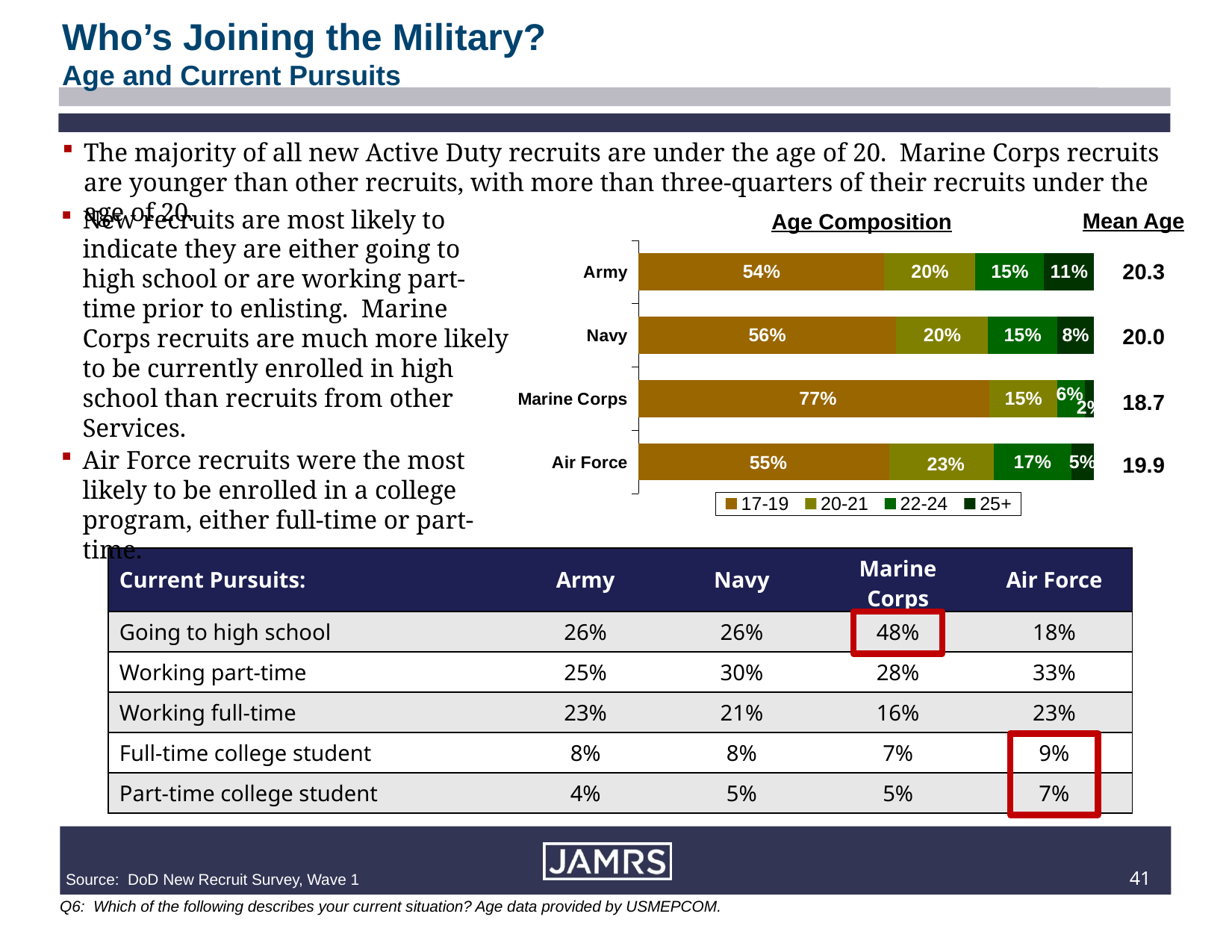
In the Age Composition chart, what is the difference between the 17-19 share for the Marine Corps and for the Army? 23% What kind of chart is the Age Composition chart? stacked bar chart How many age groups does the legend of the Age Composition chart list? 4 In the Age Composition chart, what percentage of Marine Corps recruits are aged 17-19? 77% In the Age Composition chart, what percentage of Navy recruits are aged 25+? 8% In the Age Composition chart, which Service has the lowest share of recruits aged 25+? Marine Corps How many Services are shown in the Age Composition chart? 4 In the Age Composition chart, what percentage of Air Force recruits are aged 20-21? 23% In the Age Composition chart, what percentage of Army recruits are aged 17-19? 54% In the Age Composition chart, which Service has the highest share of recruits aged 17-19? Marine Corps In the Age Composition chart, which is larger: the 22-24 share for the Air Force or for the Navy? Air Force In the Age Composition chart, which age group is shown in the darkest green colour? 25+